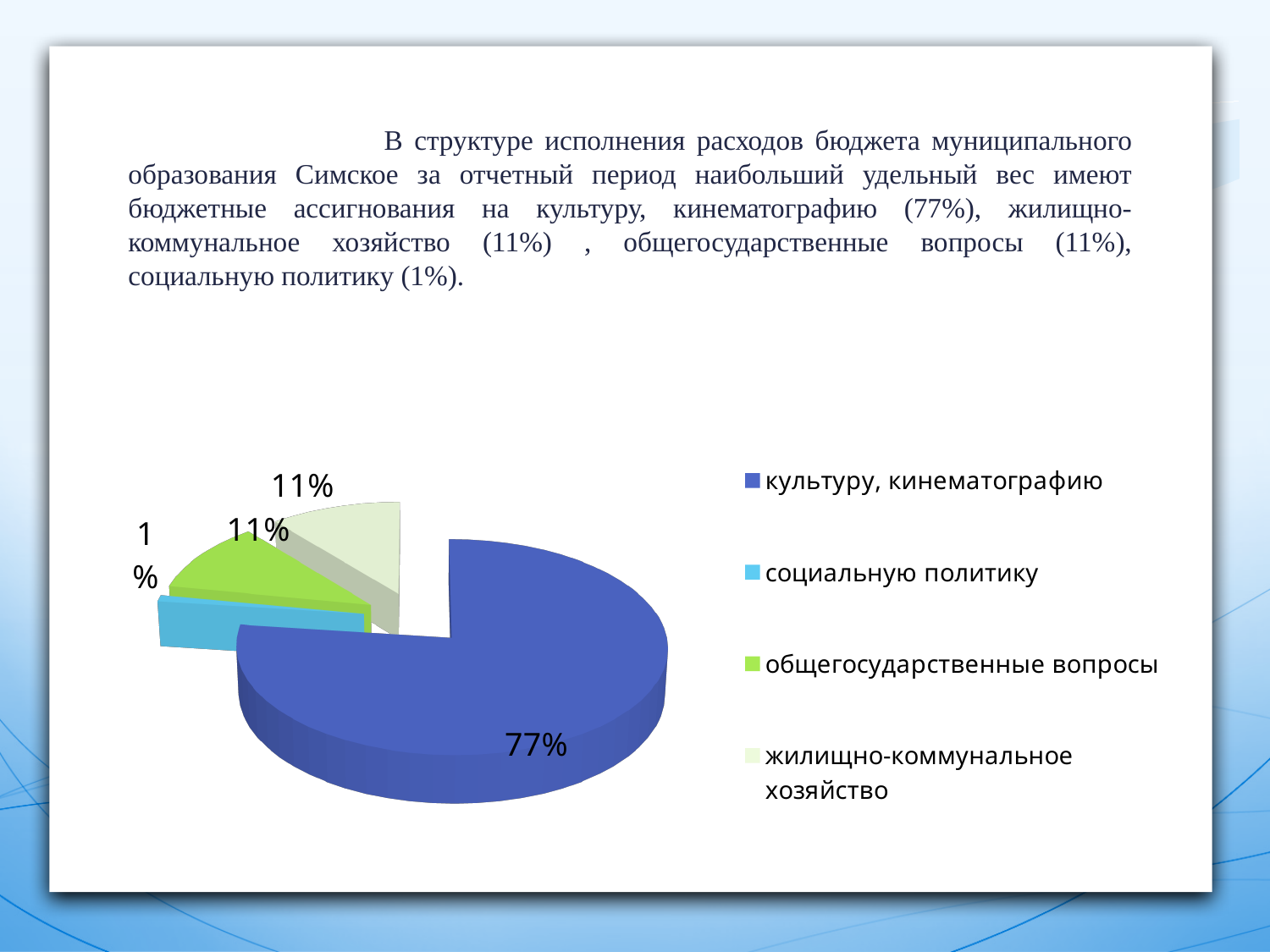
What is the difference in percentage points between the slice for культуру, кинематографию and the slice for общегосударственные вопросы? 66 How many slices does the pie chart have? 4 Which is larger: the slice for жилищно-коммунальное хозяйство or the slice for социальную политику? жилищно-коммунальное хозяйство What share of the pie does the slice for социальную политику have? 1% What share of the pie does the slice for культуру, кинематографию have? 77% What share of the pie does the slice for общегосударственные вопросы have? 11% Which category has the largest slice of the pie? культуру, кинематографию Which category has the smallest slice of the pie? социальную политику What kind of chart is shown on the slide? pie chart What colour is the slice for культуру, кинематографию? blue How many entries does the legend list? 4